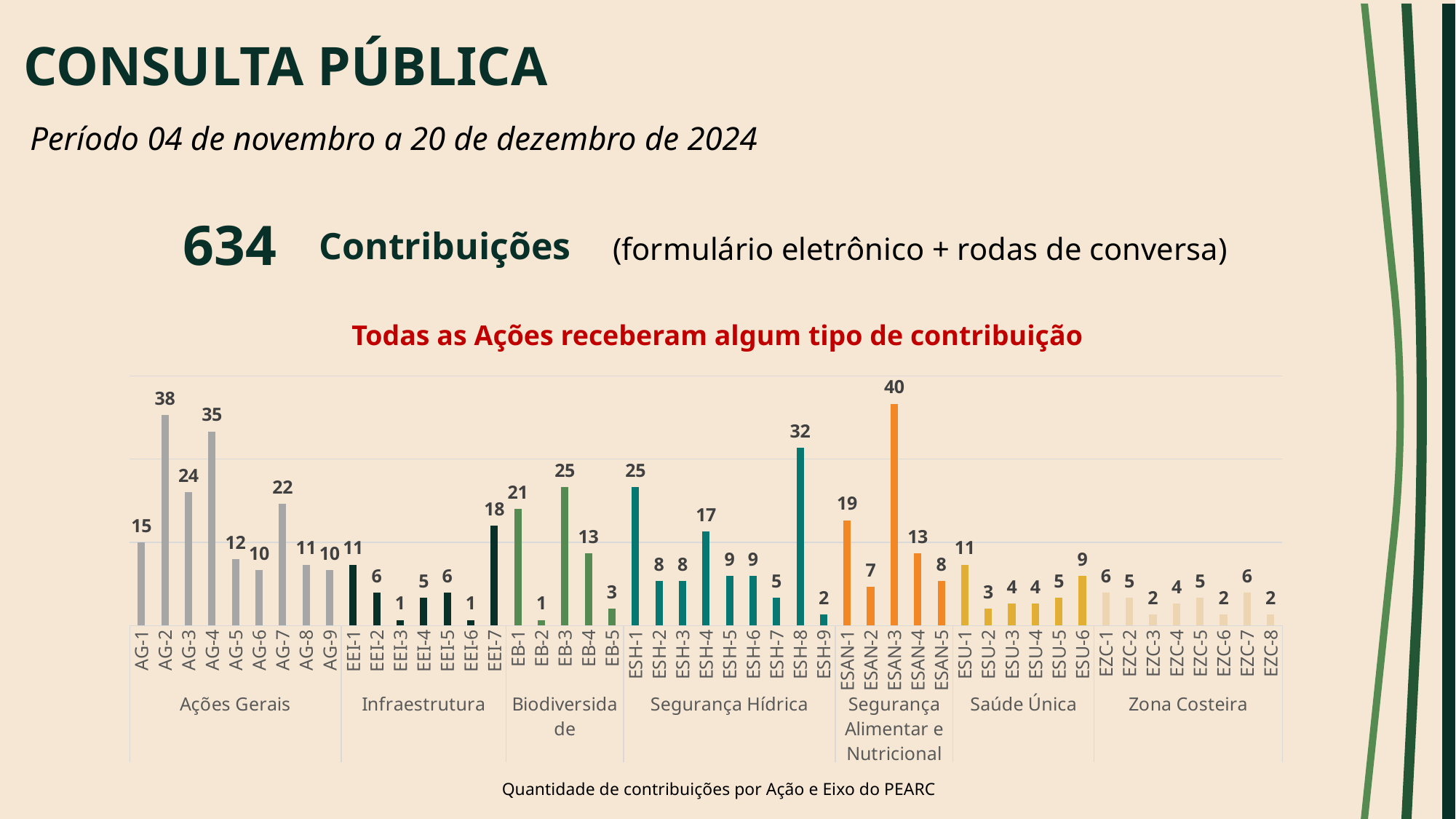
What type of chart is shown on the slide? bar chart What is the difference between the values for ESAN-3 and AG-2? 2 Which action in the Segurança Hídrica group has the lowest value? ESH-9 What caption appears below the chart? Quantidade de contribuições por Ação e Eixo do PEARC How many bars are in the Zona Costeira group? 8 What is the total of the values in the Saúde Única group? 36 What is the value shown for EB-3? 25 How many contributions did action AG-2 receive? 38 How many axis groups (eixos) are shown along the x axis of the chart? 7 Which action has the highest number of contributions in the chart? ESAN-3 Which has a higher value, EEI-7 or EB-1? EB-1 What is the value shown for ESH-8? 32